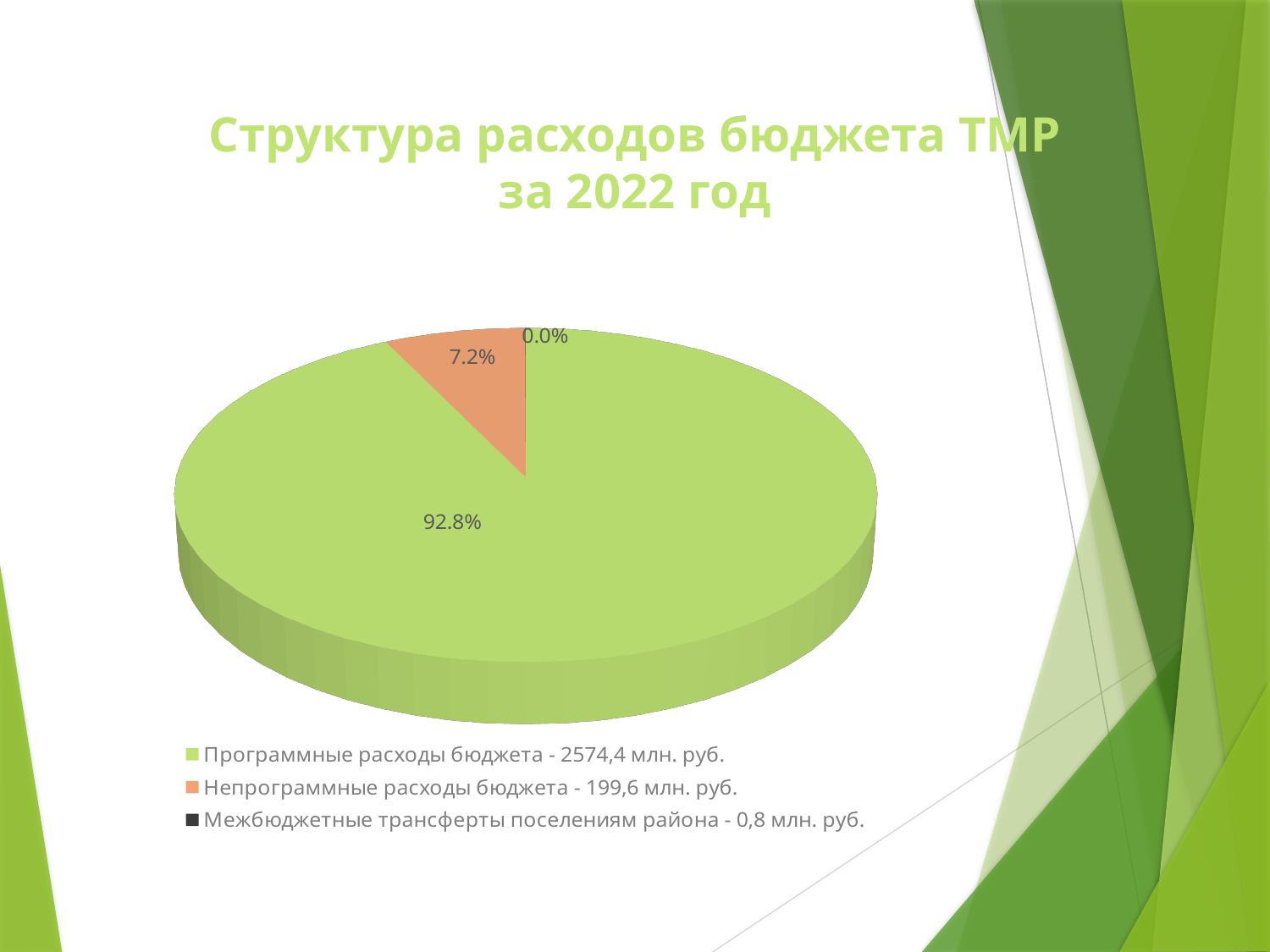
What share of the pie does "Непрограммные расходы бюджета" take? 7.2% How many entries does the legend list? 3 Which is larger: the share for "Непрограммные расходы бюджета" or the share for "Межбюджетные трансферты поселениям района"? Непрограммные расходы бюджета What percentage is shown for "Межбюджетные трансферты поселениям района"? 0.0% How many categories does the pie chart have? 3 What is the difference in percentage points between the "Программные расходы бюджета" slice and the "Непрограммные расходы бюджета" slice? 85.6% What is the title of the chart on the slide? Структура расходов бюджета ТМР за 2022 год What amount in million rubles does the legend give for "Непрограммные расходы бюджета"? 199,6 млн. руб. Which category has the smallest slice of the pie? Межбюджетные трансферты поселениям района Which category has the largest slice of the pie? Программные расходы бюджета What kind of chart is shown on the slide? pie chart What share of the pie does "Программные расходы бюджета" take? 92.8%